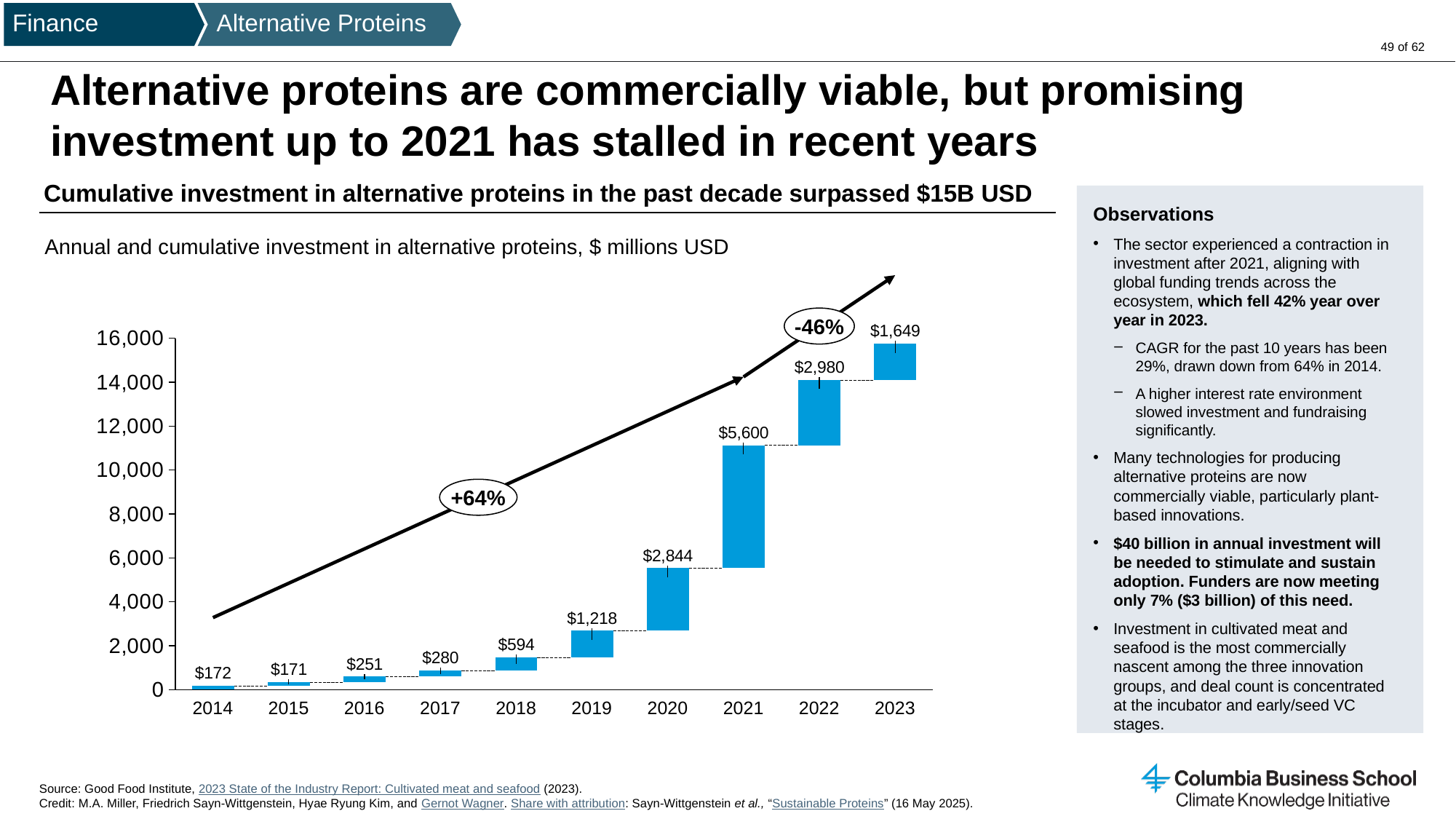
What is the annual investment value shown for 2020? $2,844 What is the difference between the 2022 and 2023 annual investment values? $1,331 What is the annual investment value shown for 2021? $5,600 Which year has the highest annual investment value? 2021 What is the annual investment value shown for 2018? $594 Is the top of the 2023 bar greater or less than 14,000 on the y axis? greater What is the difference between the 2021 and 2020 annual investment values? $2,756 Which year has the larger annual investment value, 2019 or 2022? 2022 What kind of chart is used to show annual and cumulative investment? Bar chart What percentage change is shown in the annotation near the 2022 bar? -46% How many years are shown on the x axis of the chart? 10 What is the annual investment value shown for 2023? $1,649